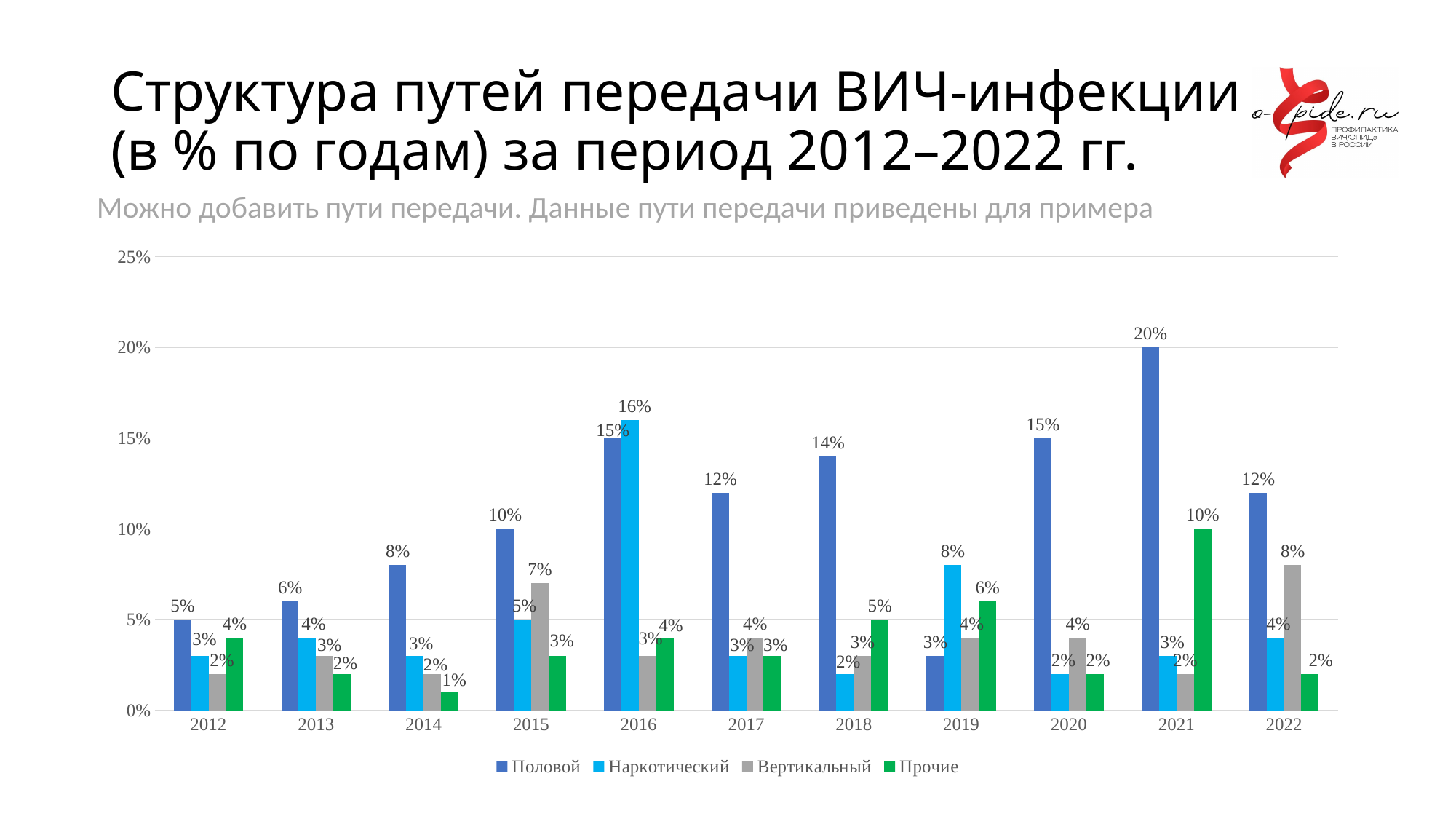
What is the value for Половой in 2021? 20% What is the value for Вертикальный in 2022? 8% In which year is the Половой value highest? 2021 What is the value for Наркотический in 2016? 16% How many years are shown on the x axis? 11 What is the value for Прочие in 2014? 1% What is the difference between the Половой value in 2021 and in 2022? 8% Which is larger in 2016: Половой or Наркотический? Наркотический How many series does the legend list? 4 In which year is the Половой value lowest? 2019 Is the value for Прочие in 2021 greater or less than 5%? greater What kind of chart is shown on the slide? bar chart